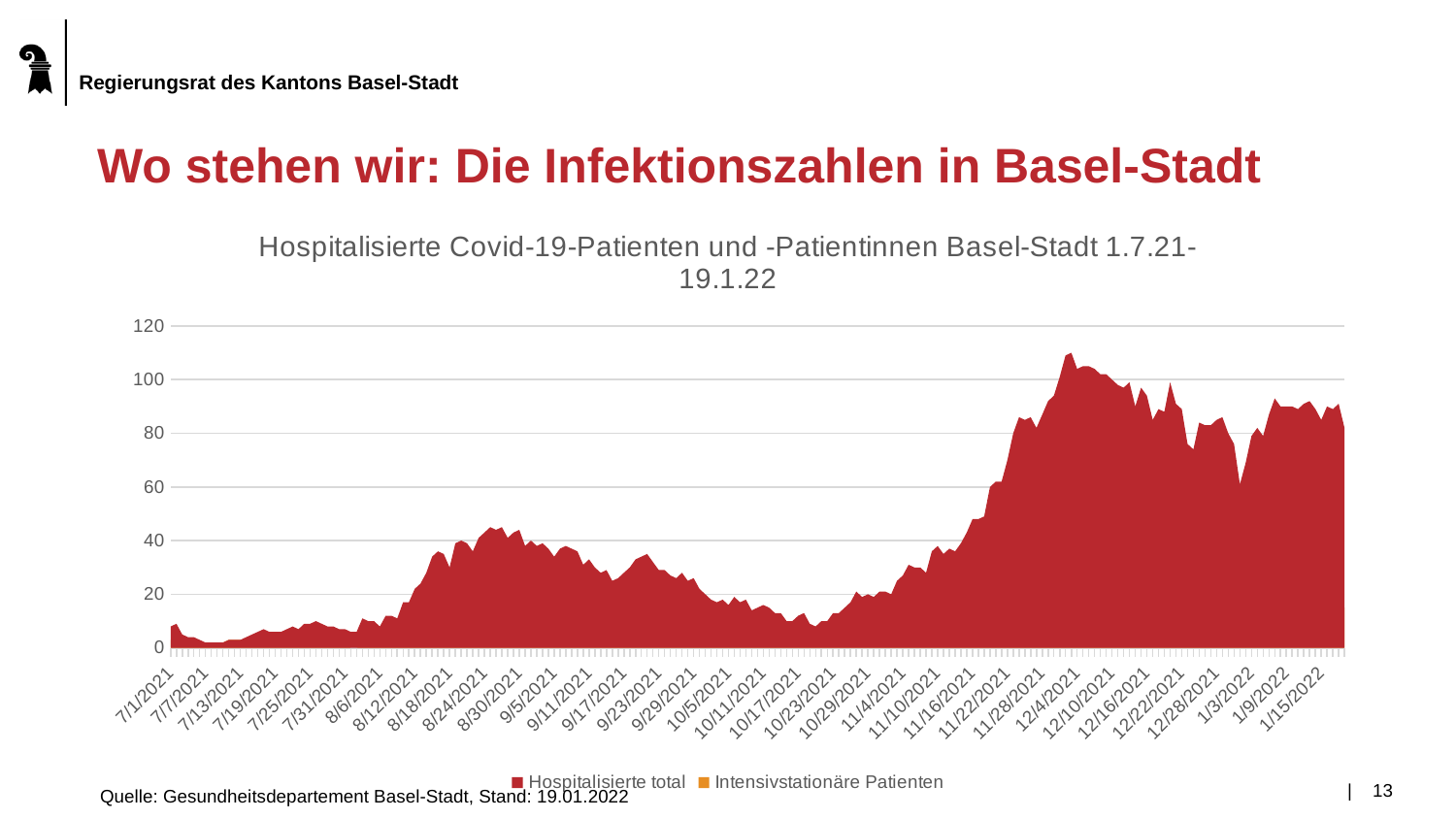
Is the value for Hospitalisierte total on 8/24/2021 greater or less than 20? greater What is the title of the chart? Hospitalisierte Covid-19-Patienten und -Patientinnen Basel-Stadt 1.7.21-19.1.22 Does the Hospitalisierte total series rise or fall between 8/30/2021 and 10/23/2021? fall Does the Hospitalisierte total series rise or fall between 10/23/2021 and 12/4/2021? rise What kind of chart is shown on the slide? Area chart Is the peak value of Hospitalisierte total greater or less than 100? greater Which series is shown in dark red? Hospitalisierte total How many series does the legend list? 2 Which is larger, the value for Hospitalisierte total on 12/4/2021 or on 7/7/2021? 12/4/2021 Is the value for Hospitalisierte total on 11/28/2021 greater or less than 60? greater